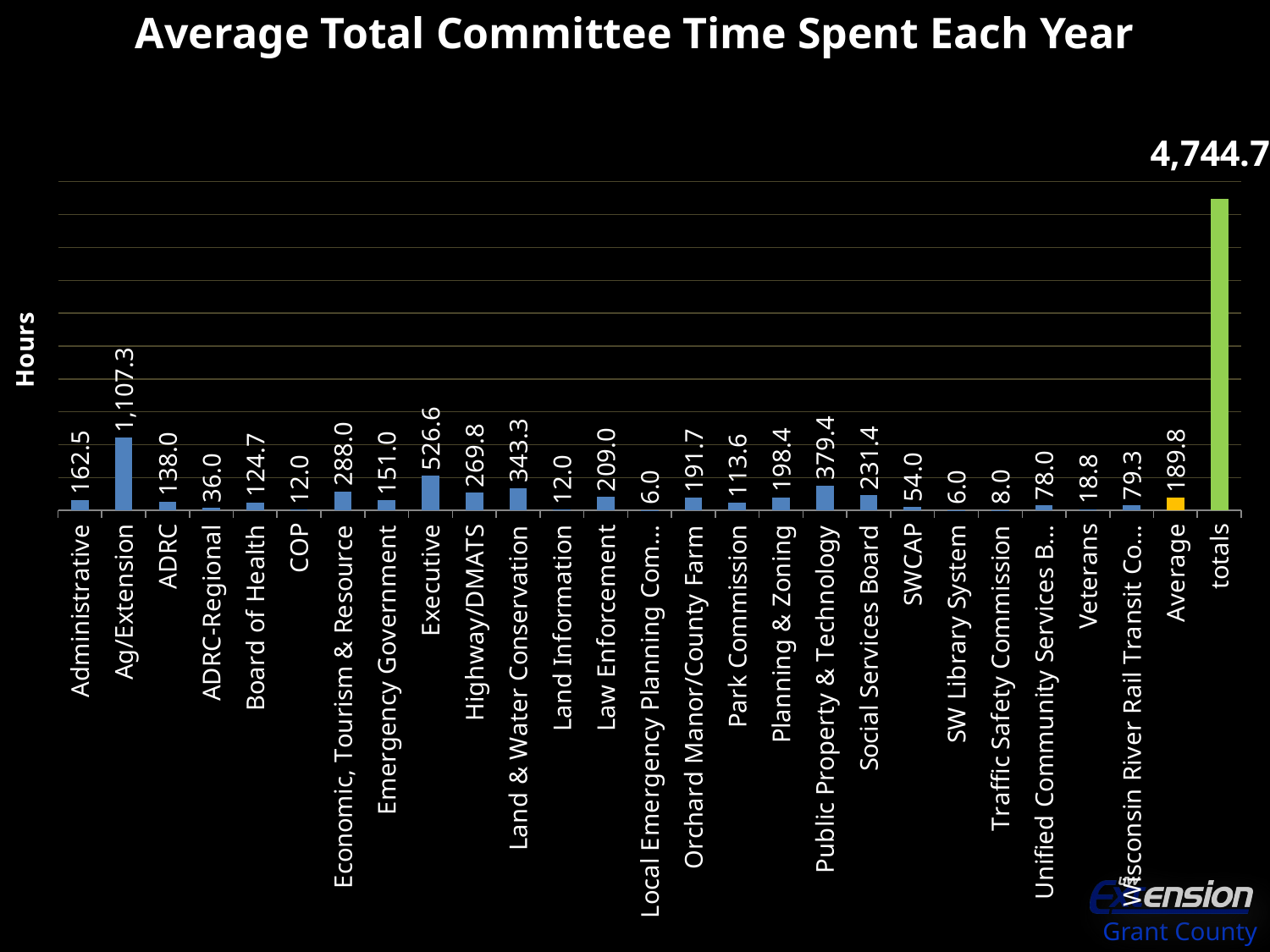
What is the value for Ag/Extension? 1,107.3 What is the value for Public Property & Technology? 379.4 What is the difference between the values for Executive and Land & Water Conservation? 183.3 What is the value for Executive? 526.6 What is the title of the chart? Average Total Committee Time Spent Each Year What is the difference between the values for Administrative and ADRC? 24.5 What kind of chart is shown on the slide? Bar chart Which is larger, the value for Highway/DMATS or the value for Law Enforcement? Highway/DMATS Excluding the Average and totals bars, which committee has the highest value? Ag/Extension How many bars are plotted on the chart, including the Average and totals bars? 27 What is the value shown for the totals bar? 4,744.7 What is the value shown for the Average bar? 189.8